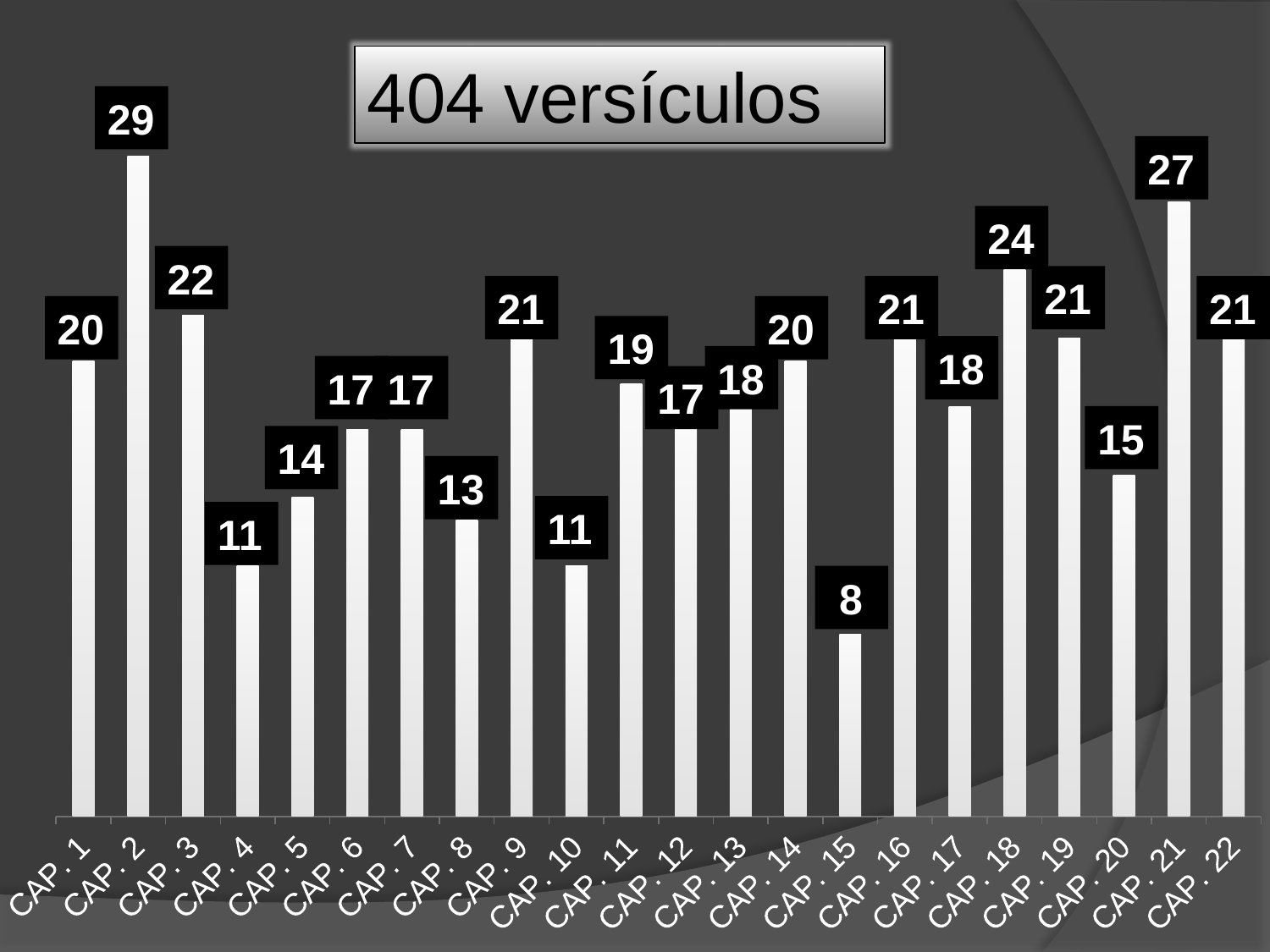
What is the difference between the values for CAP. 2 and CAP. 21? 2 What is the title shown on the slide? 404 versículos Which category has the lowest value? CAP. 15 What kind of chart is shown on the slide? Bar chart What is the value for CAP. 2? 29 What is the difference between the values for CAP. 18 and CAP. 4? 13 What is the value for CAP. 18? 24 Which category has the highest value? CAP. 2 What is the value for CAP. 15? 8 What is the value for CAP. 9? 21 Which is larger, the value for CAP. 3 or the value for CAP. 20? CAP. 3 How many categories are shown on the x axis? 22